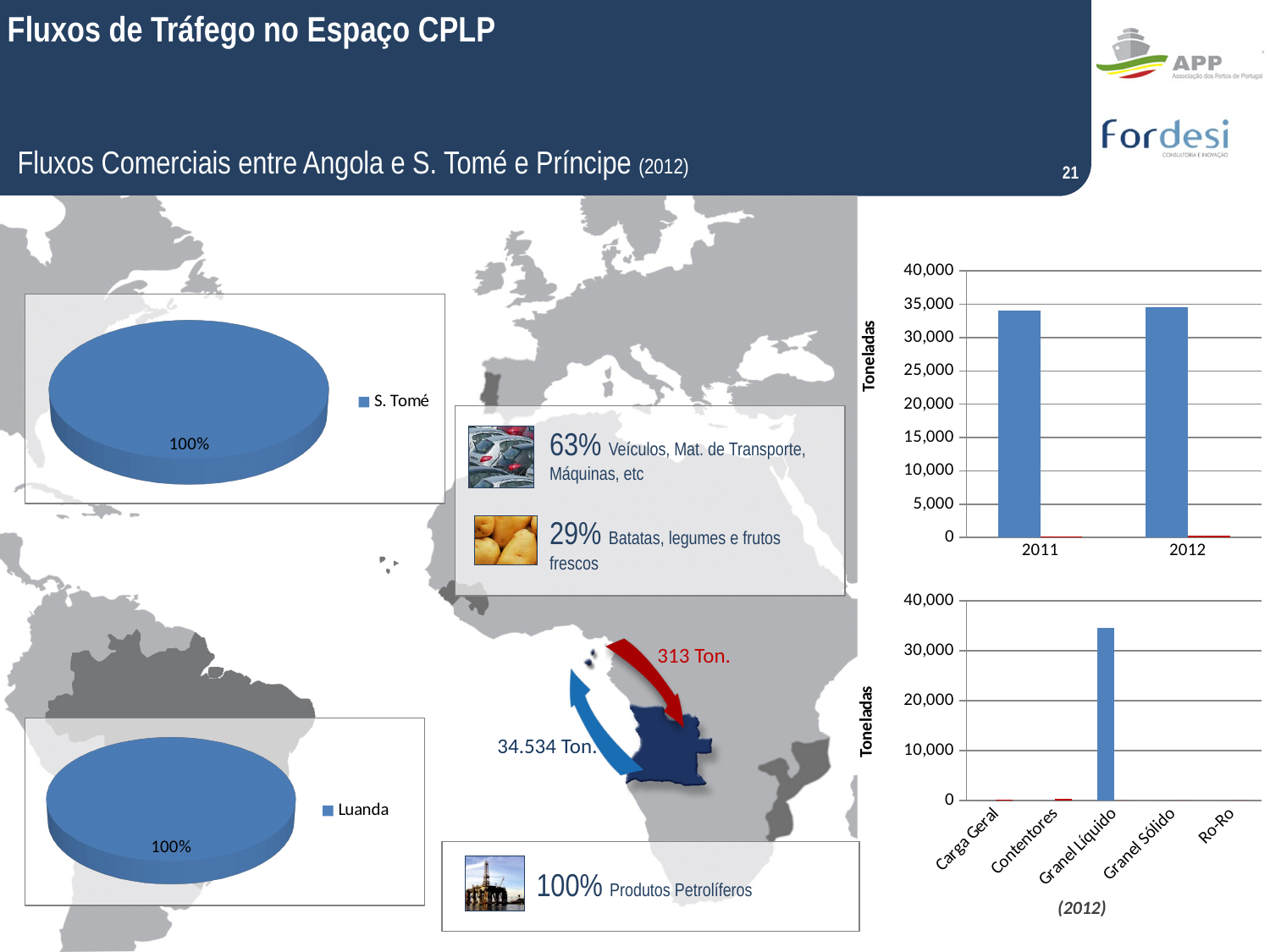
In the upper-left pie chart, what share does S. Tomé hold? 100% In the bottom-right bar chart, how many cargo categories are shown on the x axis? 5 What is the y-axis label of the top-right bar chart? Toneladas In the bottom-right bar chart, is the value for Granel Líquido greater or less than 30,000? greater What kind of chart is the top-right chart with the years 2011 and 2012? Bar chart In the lower-left pie chart, what share does Luanda hold? 100% In the top-right bar chart, how many years are shown on the x axis? 2 In the bottom-right bar chart, which cargo category has the highest value? Granel Líquido In the top-right bar chart, is the value of the blue bar for 2011 greater or less than 30,000? greater What kind of chart is the upper-left chart with the S. Tomé legend? Pie chart What is the legend entry of the lower-left pie chart? Luanda